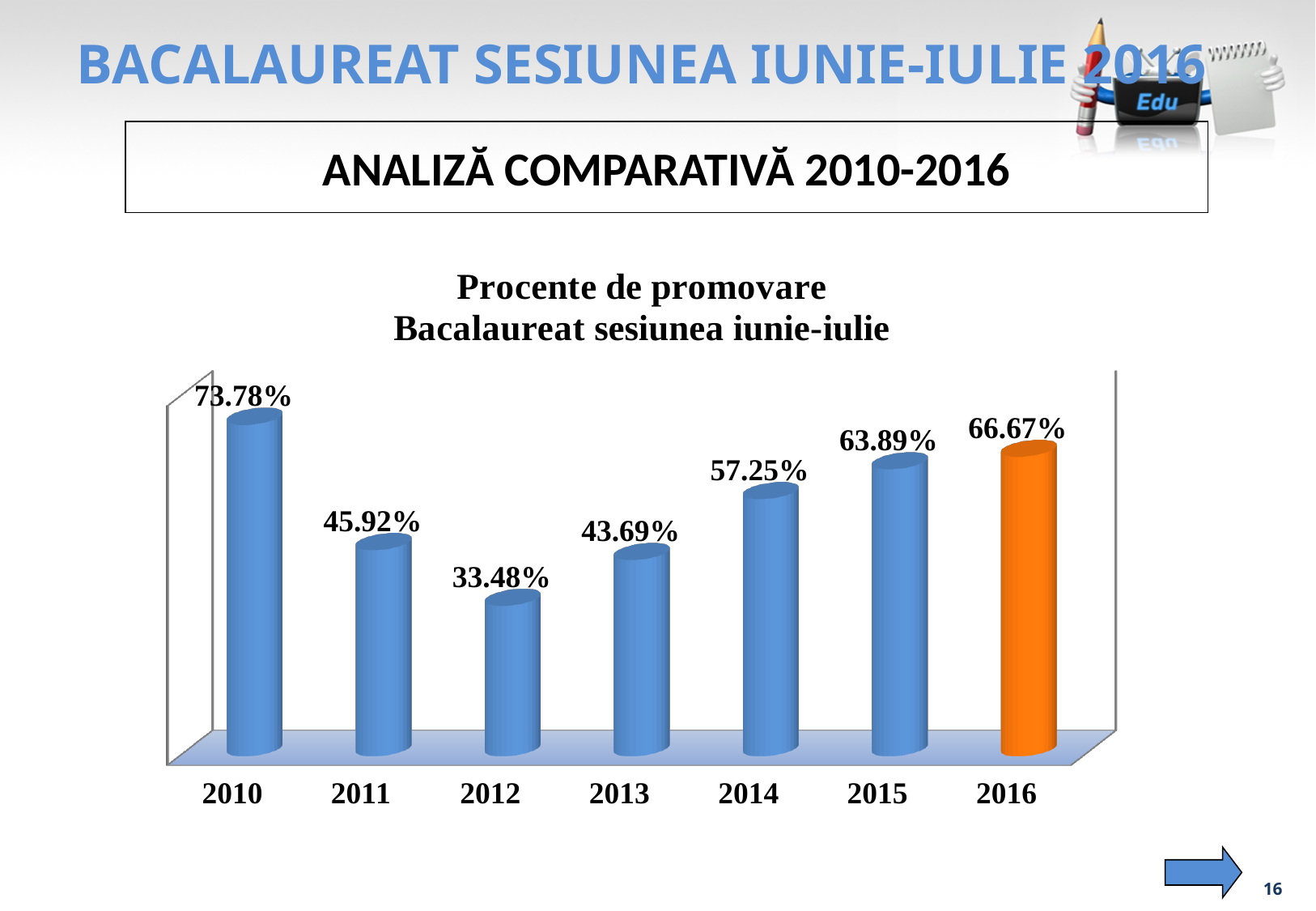
Which year has a higher pass rate, 2011 or 2013? 2011 Which year has the lowest pass rate? 2012 What is the difference between the pass rates for 2010 and 2012? 40.30% How many years are shown on the chart? 7 What is the pass rate shown for 2012? 33.48% Do the pass rates rise or fall from 2012 to 2015? Rise What kind of chart is shown on the slide? Bar chart Which year's bar is coloured orange instead of blue? 2016 Which year has the highest pass rate? 2010 What is the pass rate shown for 2010? 73.78% What is the pass rate shown for 2016? 66.67% What is the difference between the pass rates for 2016 and 2015? 2.78%